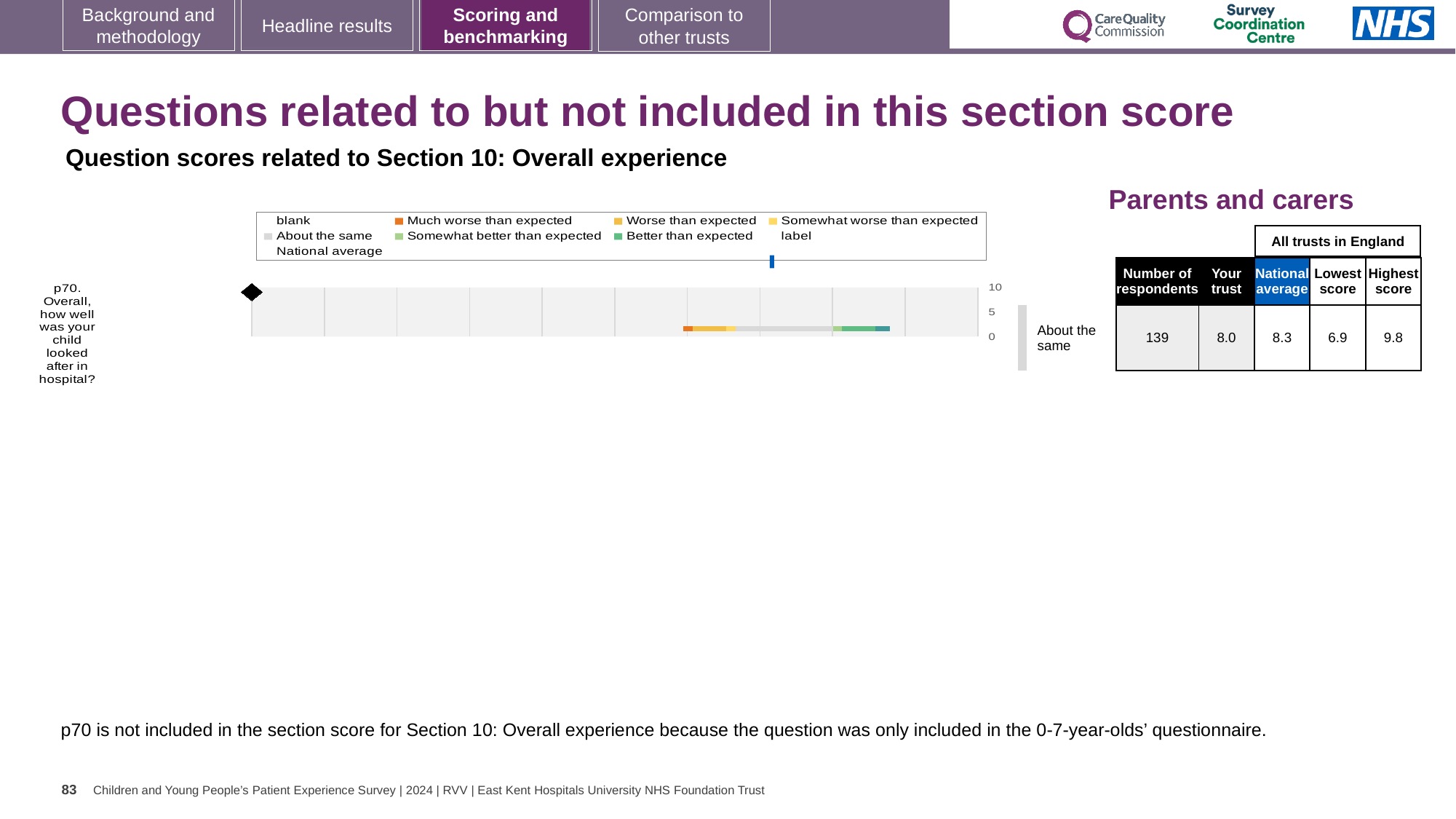
How many questions are plotted on the chart? 1 What is the national average score for p70? 8.3 Which is larger for p70: the 'Your trust' score or the national average? National average What is the 'Your trust' score for p70 (Overall, how well was your child looked after in hospital?)? 8.0 What is the lowest score among all trusts in England for p70? 6.9 Is the 'Your trust' score for p70 greater or less than 5 on the chart's axis? greater How many respondents answered question p70? 139 What benchmark category label is shown next to the bar for p70? About the same What kind of chart is used to show the score for question p70? bar chart What is the highest score among all trusts in England for p70? 9.8 What is the difference between the highest and lowest scores for p70 across all trusts in England? 2.9 What is the difference between the national average and the 'Your trust' score for p70? 0.3